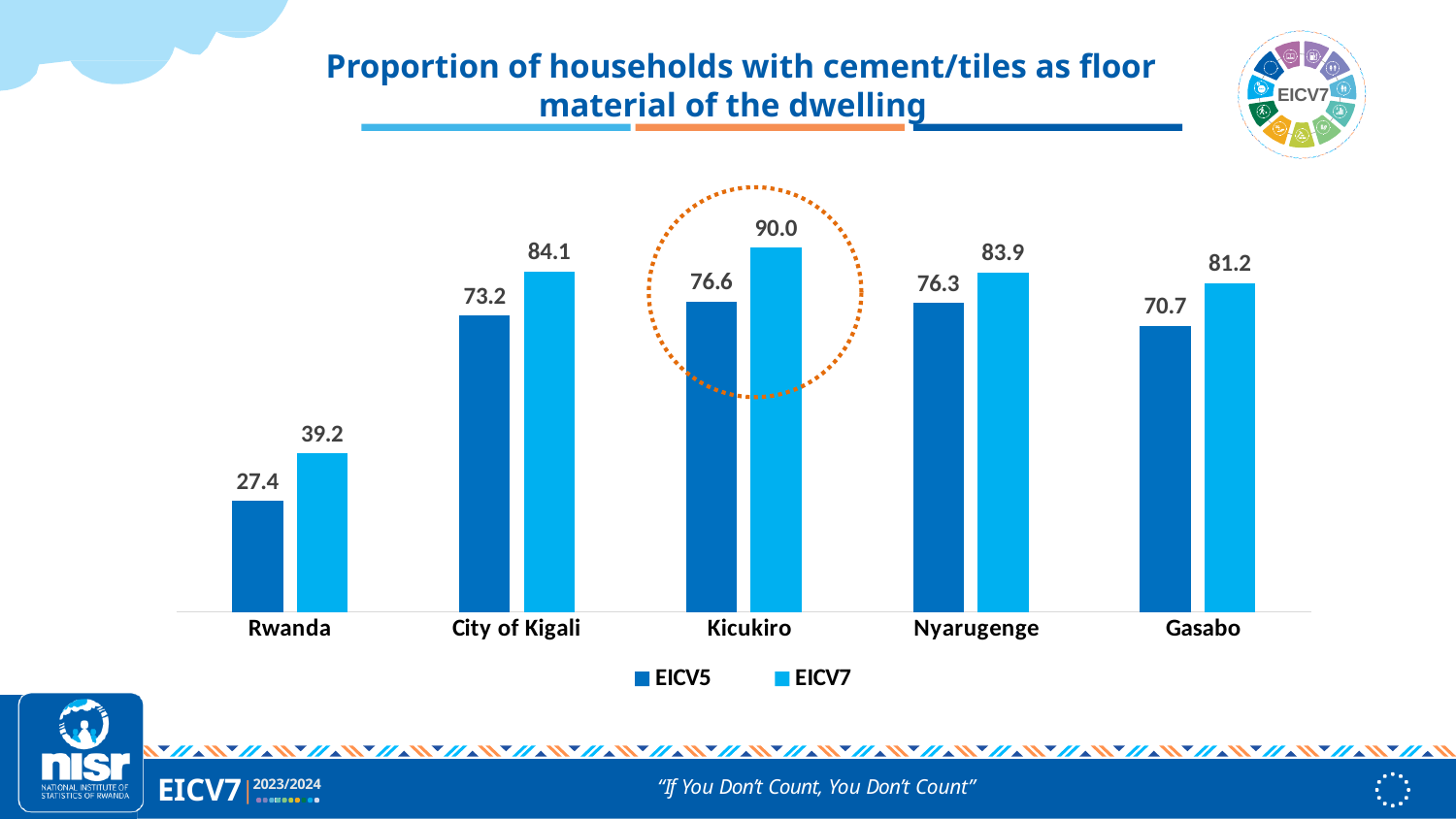
How many series does the legend list? 2 What is the EICV7 value for Gasabo? 81.2 Which category has the highest EICV7 value? Kicukiro How many categories are shown on the x axis? 5 What is the EICV7 value for Kicukiro? 90.0 What is the difference between the EICV7 values for Kicukiro and Gasabo? 8.8 Which category has the lowest EICV5 value? Rwanda Which category is highlighted with a dashed orange circle? Kicukiro What is the difference between the EICV7 and EICV5 values for Rwanda? 11.8 What is the EICV5 value for Rwanda? 27.4 Which is larger, the EICV5 value for City of Kigali or the EICV5 value for Nyarugenge? Nyarugenge What kind of chart is shown on the slide? Bar chart